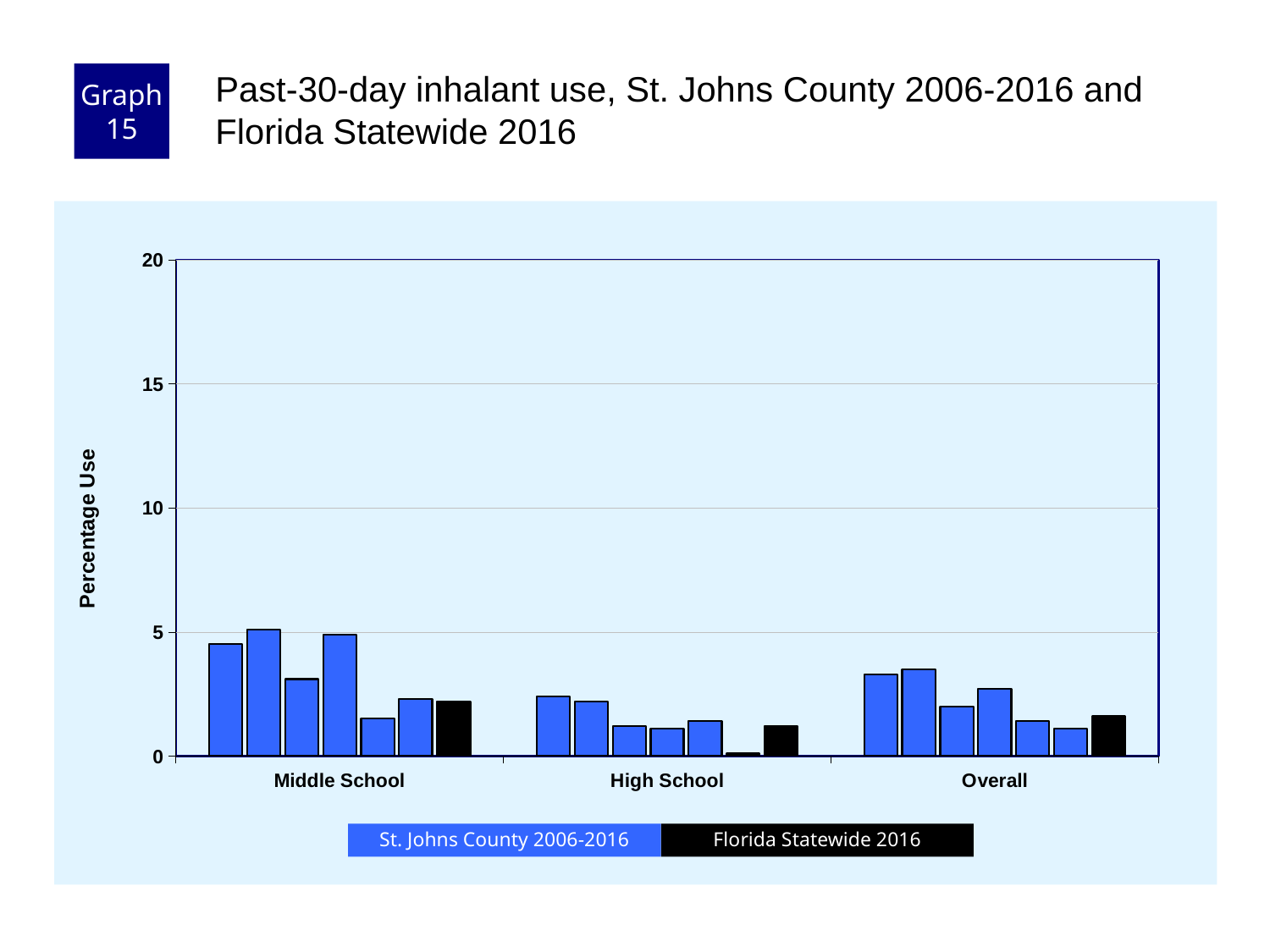
How many category groups are shown along the x axis? 3 Is the highest St. Johns County bar in the High School group greater or less than 5? less What is the label on the y axis? Percentage Use Which series is shown in black in the legend? Florida Statewide 2016 Which is larger: the Florida Statewide 2016 value for Middle School or for High School? Middle School Among the three groups, which has the highest Florida Statewide 2016 value? Middle School Is the value for Florida Statewide 2016 in the Overall group greater or less than 5? less What kind of chart is shown on the slide? bar chart How many series does the legend list? 2 Among the three groups, which has the lowest Florida Statewide 2016 value? High School Is the value for Florida Statewide 2016 in the High School group greater or less than 5? less